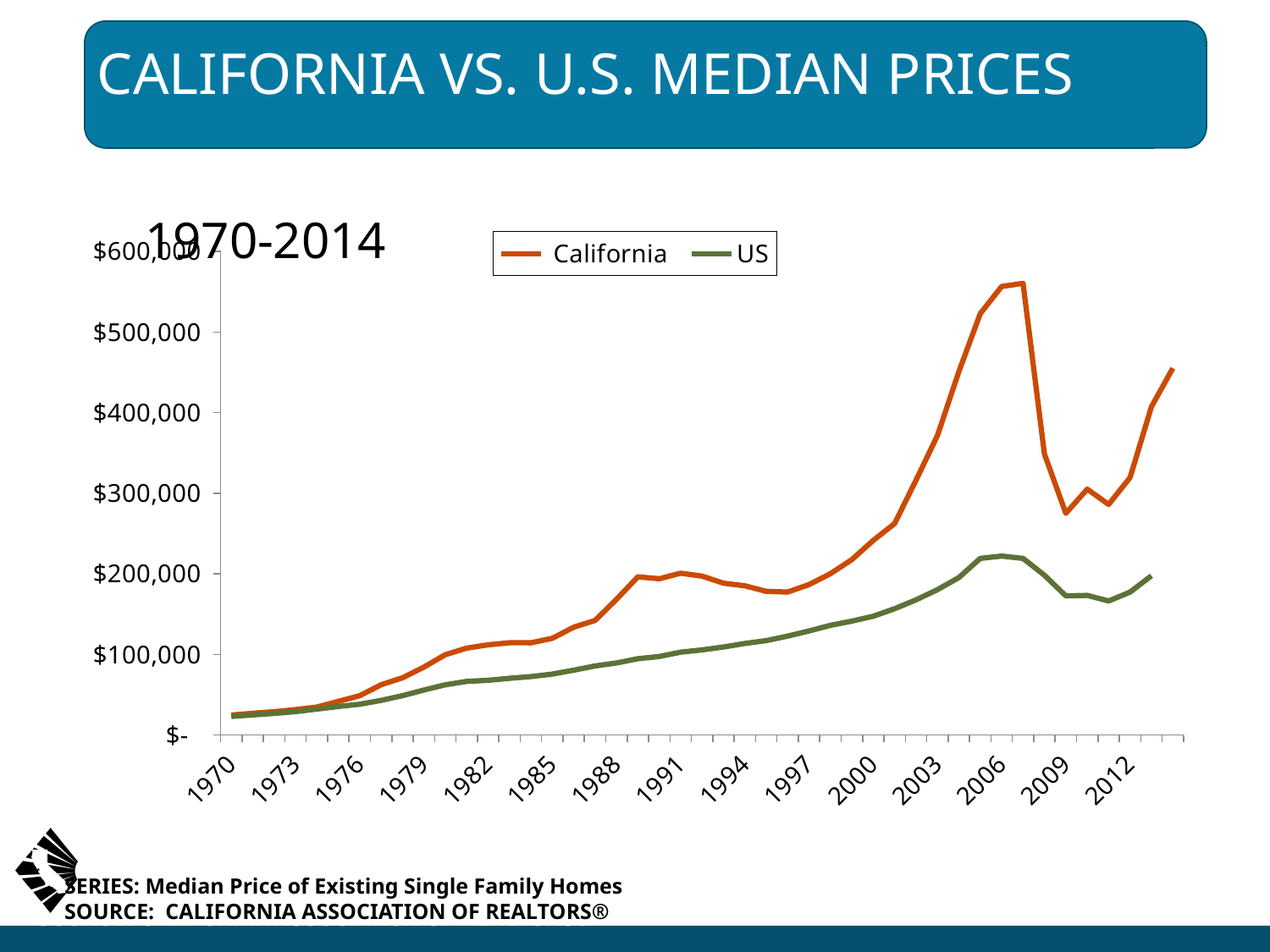
Is the value for California in 2009 greater or less than $400,000? less Is the value for US in 2012 greater or less than $200,000? less What colour is the line for California? orange Which two series are listed in the chart legend? California and US Is the value for California in 1970 greater or less than $100,000? less How many series does the legend list? 2 What kind of chart is shown on the slide? line chart Does the California median price rise or fall from 2007 to 2009? fall Which series has the higher median price in 2006, California or US? California Does the US median price rise or fall from 1970 to 2006? rise